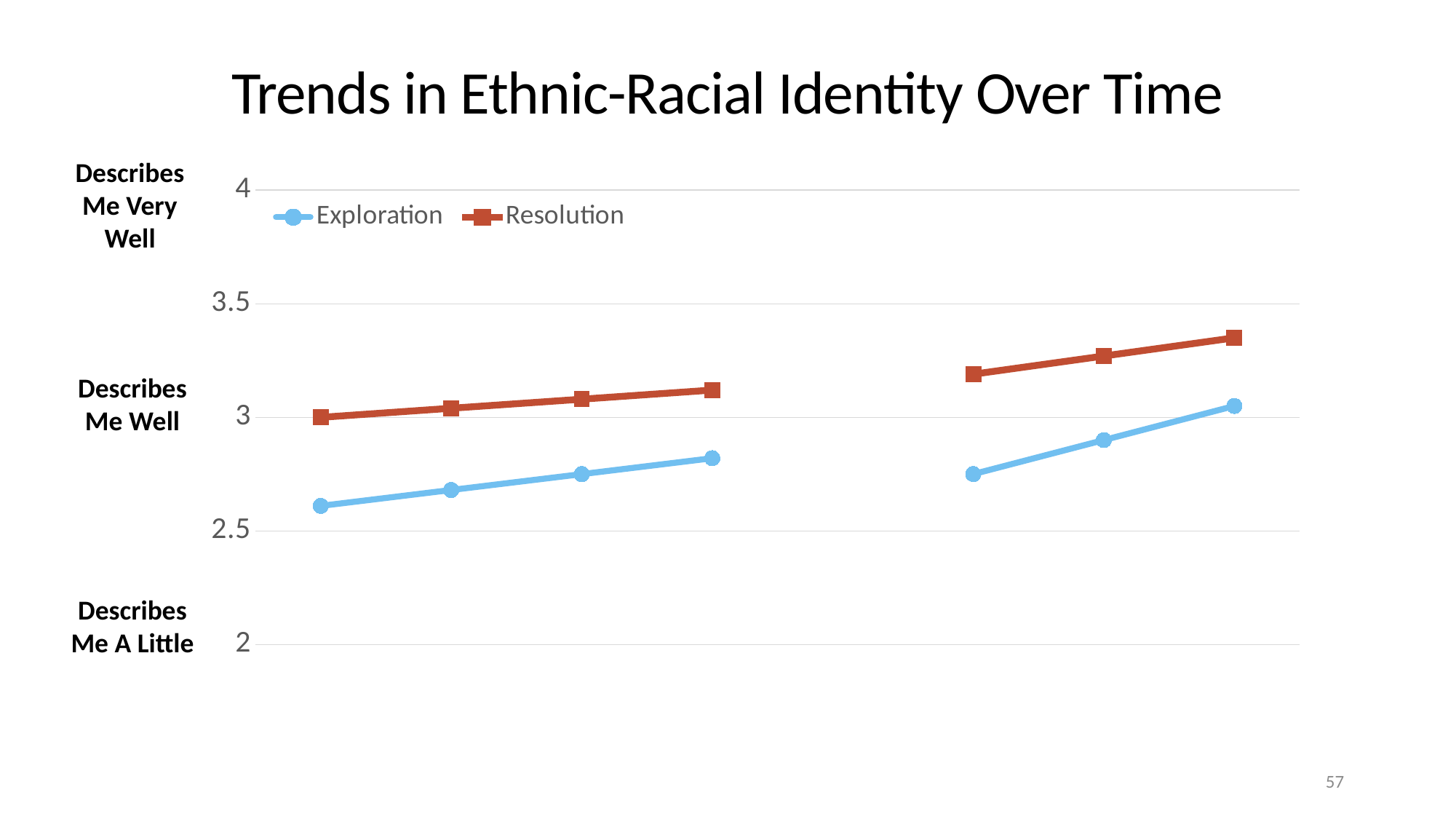
Is the last (rightmost) Exploration value greater or less than 3? greater How many series does the legend list? 2 What kind of chart is shown on the slide? line chart What is the title of the chart? Trends in Ethnic-Racial Identity Over Time Do the Resolution values rise or fall from left to right? rise How many data points are plotted for the Resolution series? 7 Which series has higher values throughout the chart, Exploration or Resolution? Resolution Is the first (leftmost) Exploration value greater or less than 2.5? greater Is the first (leftmost) Exploration value greater or less than 3? less Which series is drawn in blue with circle markers? Exploration Do the Exploration values rise or fall from left to right? rise